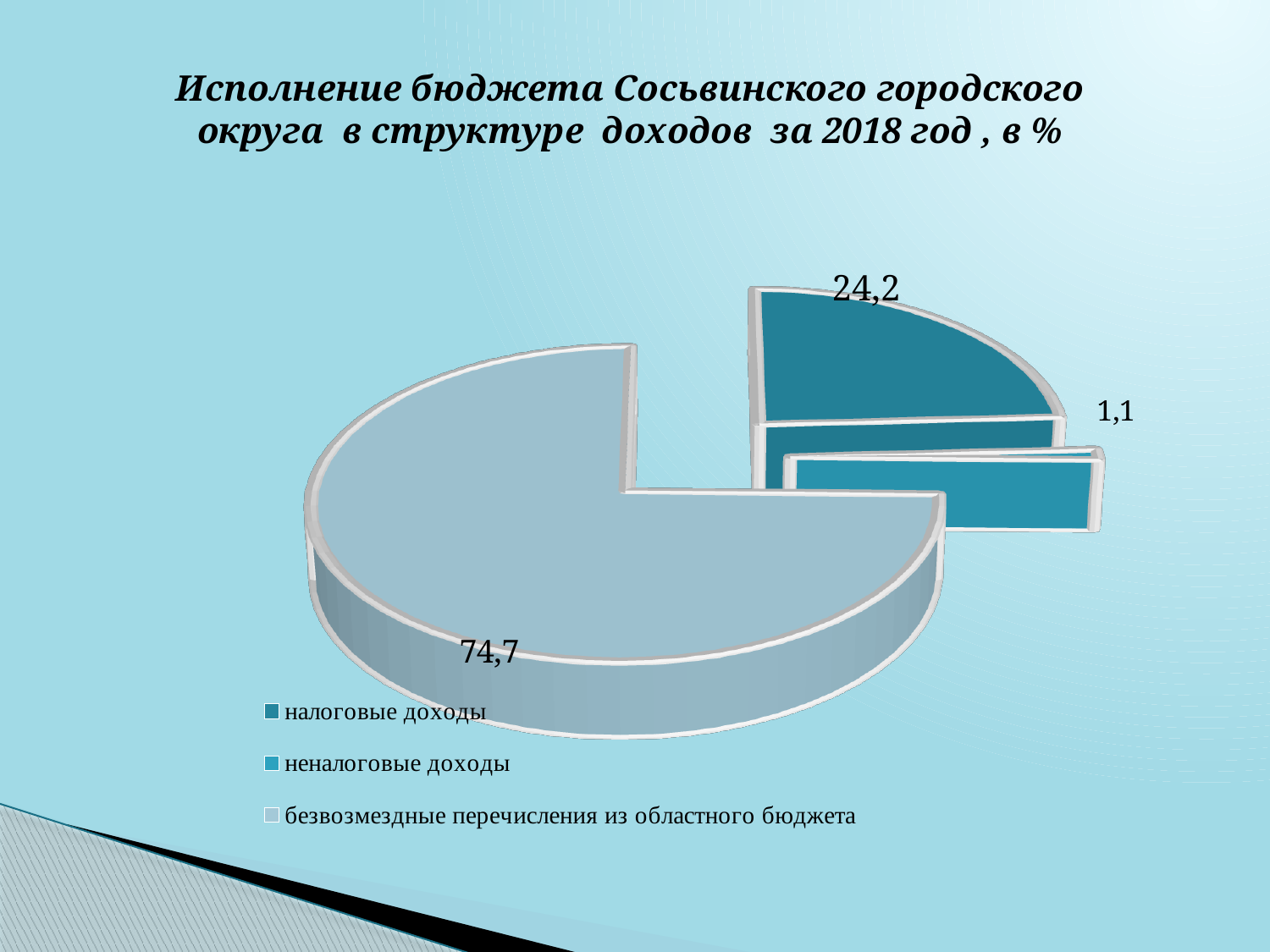
What is the difference between the values for налоговые доходы and неналоговые доходы? 23,1 What is the value for налоговые доходы? 24,2 Which category has the largest share of the pie? безвозмездные перечисления из областного бюджета What year does the chart title refer to? 2018 Which category has the smallest share of the pie? неналоговые доходы What is the value for безвозмездные перечисления из областного бюджета? 74,7 What kind of chart is shown on the slide? pie chart Which is larger, налоговые доходы or неналоговые доходы? налоговые доходы How many slices does the pie chart have? 3 What is the difference between the values for безвозмездные перечисления из областного бюджета and налоговые доходы? 50,5 What is the value for неналоговые доходы? 1,1 How many entries does the legend list? 3